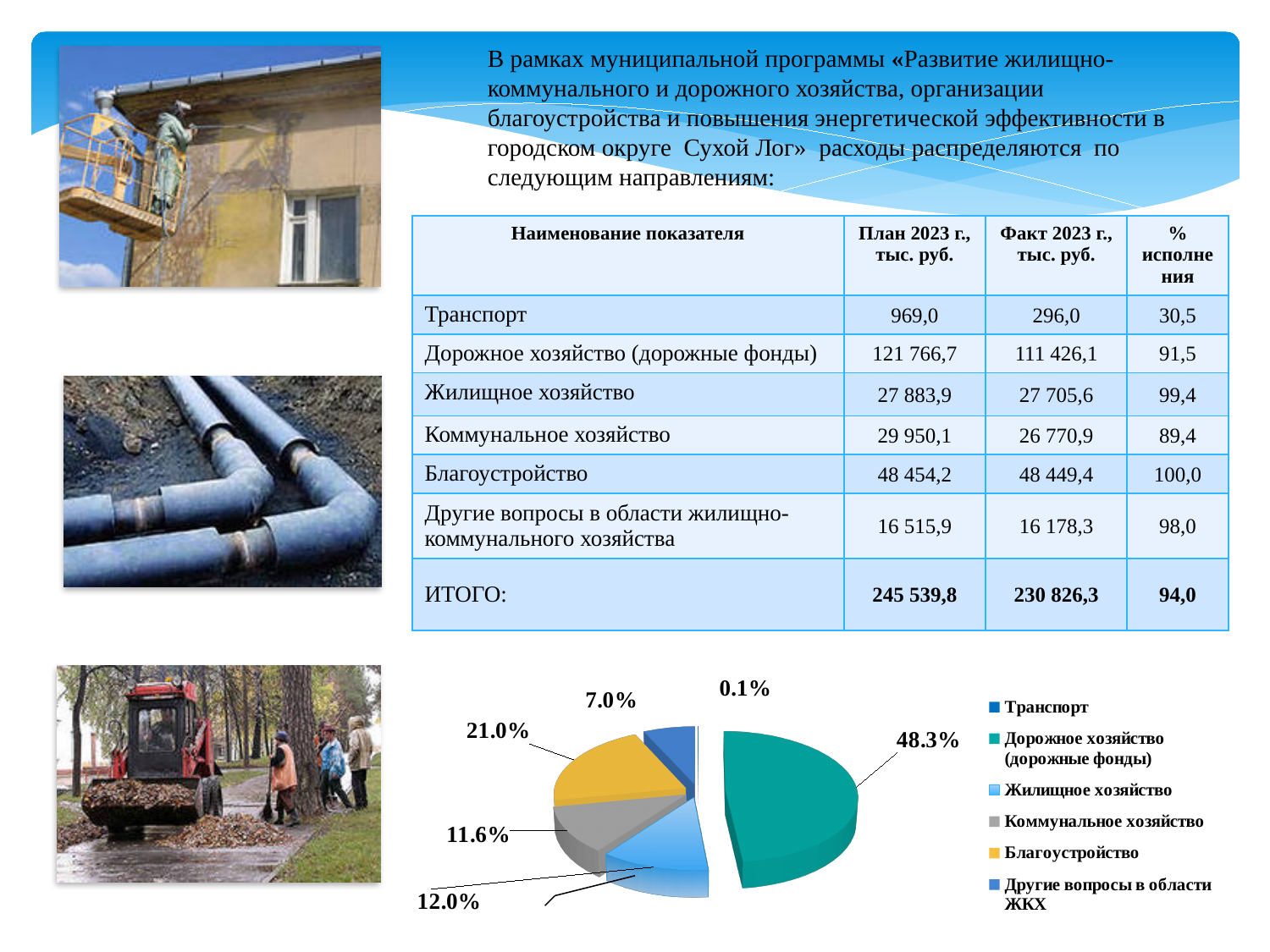
In the pie chart, what share does Коммунальное хозяйство have? 11.6% In the pie chart, what share does Благоустройство have? 21.0% In the pie chart, which is larger: the share of Жилищное хозяйство or the share of Коммунальное хозяйство? Жилищное хозяйство In the pie chart, what share does Дорожное хозяйство (дорожные фонды) have? 48.3% Which category has the largest slice in the pie chart? Дорожное хозяйство (дорожные фонды) In the pie chart, what share does Другие вопросы в области ЖКХ have? 7.0% What kind of chart is shown at the bottom of the slide? pie chart Which category has the smallest slice in the pie chart? Транспорт What colour is the slice for Благоустройство in the pie chart? yellow How many categories does the pie chart's legend list? 6 In the pie chart, what share does Транспорт have? 0.1% In the pie chart, what is the difference between the shares of Благоустройство and Жилищное хозяйство? 9.0%